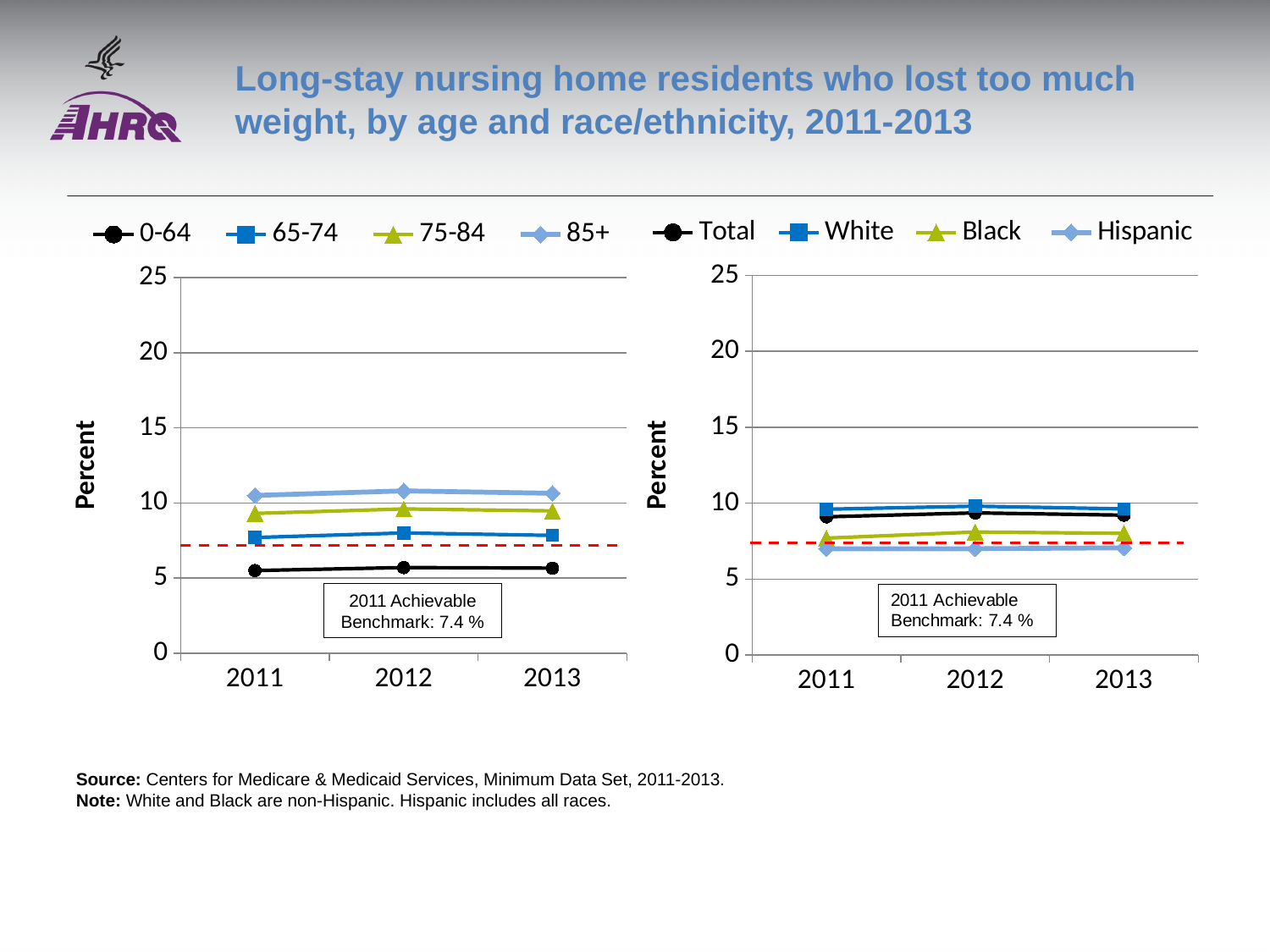
What is the 2011 Achievable Benchmark shown on the charts? 7.4 % In the left chart (by age), is the value for 75-84 in 2012 greater or less than 5? greater How many years are shown on the x axis of the right chart (by race/ethnicity)? 3 How many series does the legend of the left chart (by age) list? 4 In the left chart (by age), which age group has the highest percentage in 2013? 85+ In the right chart (by race/ethnicity), which group has the highest percentage in 2012? White What kind of chart is the left chart (by age)? line chart In the left chart (by age), which is larger in 2013, the value for 85+ or the value for 0-64? 85+ In the left chart (by age), which age group has the lowest percentage in 2012? 0-64 In the right chart (by race/ethnicity), which group has the lowest percentage in 2011? Hispanic In the left chart (by age), is the value for 0-64 in 2011 greater or less than 10? less How many series does the legend of the right chart (by race/ethnicity) list? 4